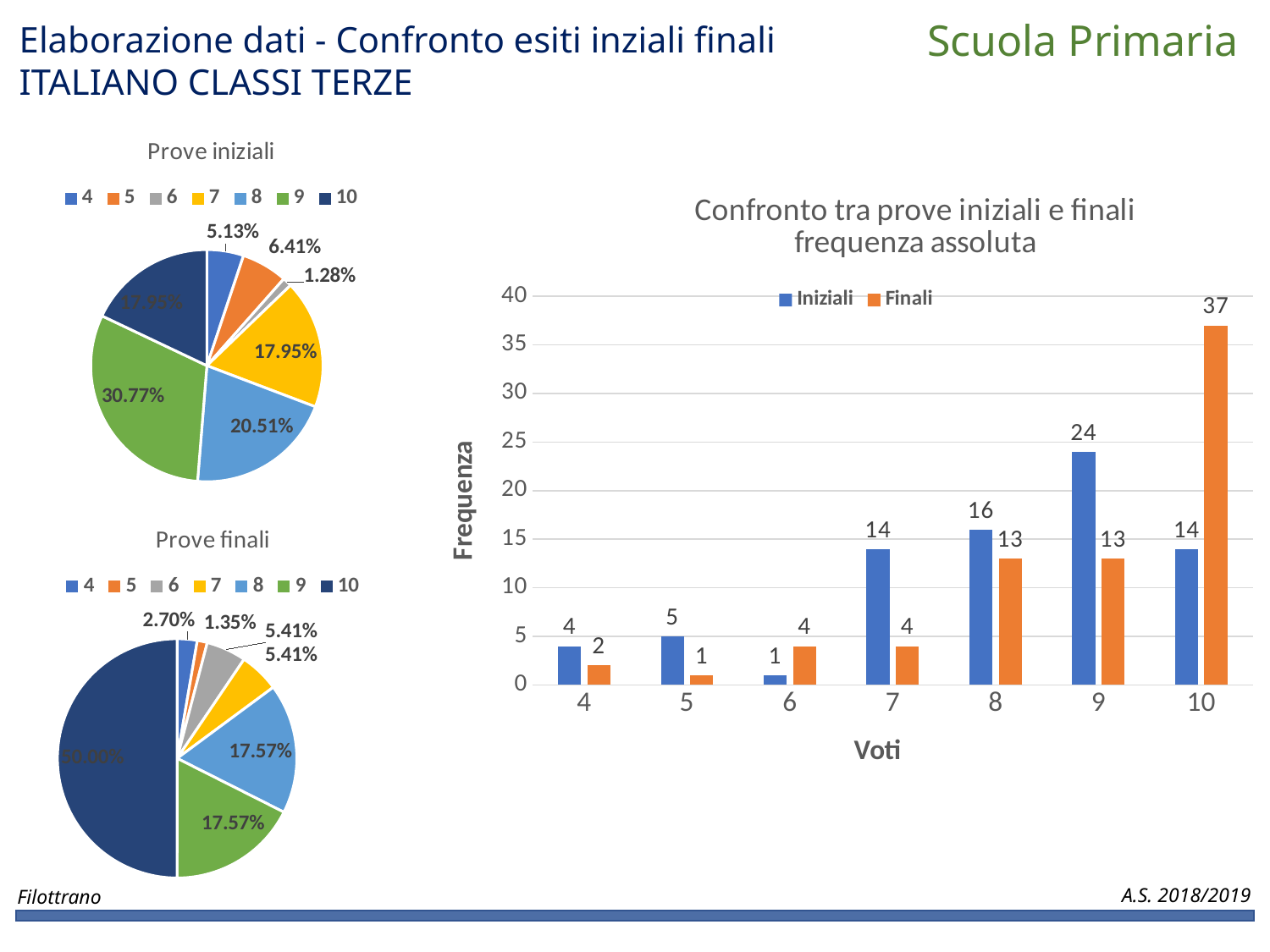
In the pie chart 'Prove finali', what share does voto 8 have? 17.57% In the bar chart 'Confronto tra prove iniziali e finali frequenza assoluta', what is the Iniziali value for voto 9? 24 In the pie chart 'Prove iniziali', what share does voto 9 have? 30.77% In the bar chart 'Confronto tra prove iniziali e finali frequenza assoluta', what is the Finali value for voto 10? 37 In the bar chart 'Confronto tra prove iniziali e finali frequenza assoluta', which voto has the highest Iniziali value? 9 What kind of chart is 'Confronto tra prove iniziali e finali frequenza assoluta'? Bar chart In the pie chart 'Prove iniziali', what share does voto 6 have? 1.28% In the bar chart 'Confronto tra prove iniziali e finali frequenza assoluta', how many voti categories are shown on the x axis? 7 In the bar chart 'Confronto tra prove iniziali e finali frequenza assoluta', which is larger for voto 8: Iniziali or Finali? Iniziali In the bar chart 'Confronto tra prove iniziali e finali frequenza assoluta', how many series does the legend list? 2 In the bar chart 'Confronto tra prove iniziali e finali frequenza assoluta', which voto has the lowest Finali value? 5 In the bar chart 'Confronto tra prove iniziali e finali frequenza assoluta', what is the difference between the Finali and Iniziali values for voto 10? 23